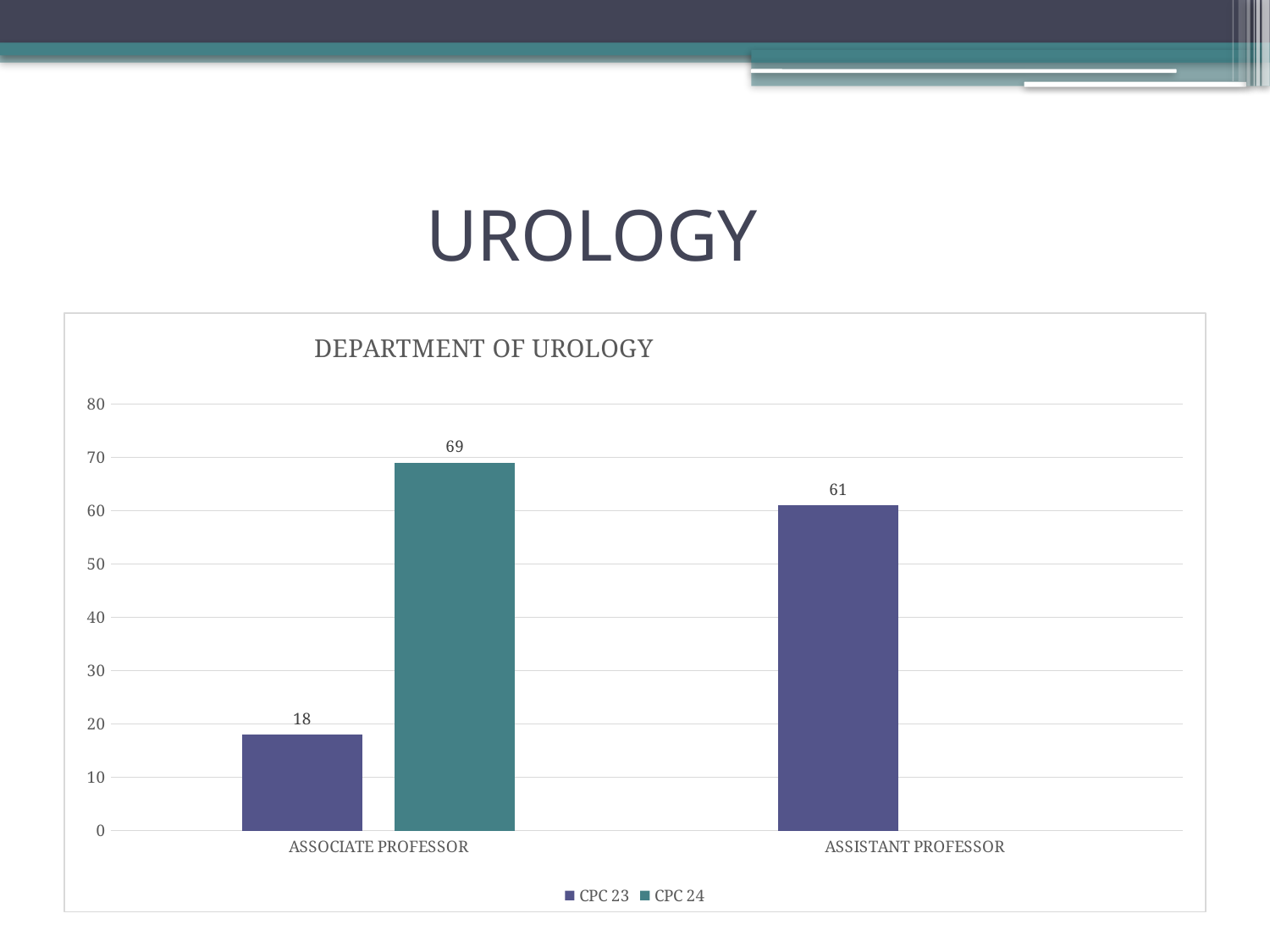
What kind of chart is shown on the slide? Bar chart Which category has the lowest CPC 23 value? Associate Professor Is the CPC 23 value for Associate Professor greater or less than 20? less What is the difference between the CPC 24 and CPC 23 values for Associate Professor? 51 What is the CPC 23 value for Associate Professor? 18 Which category has the highest CPC 23 value? Assistant Professor How many series does the legend list? 2 How many categories are shown on the x axis? 2 Which is larger: the CPC 24 value for Associate Professor or the CPC 23 value for Assistant Professor? CPC 24 value for Associate Professor What is the CPC 24 value for Associate Professor? 69 What is the CPC 23 value for Assistant Professor? 61 What is the difference between the CPC 23 values for Assistant Professor and Associate Professor? 43